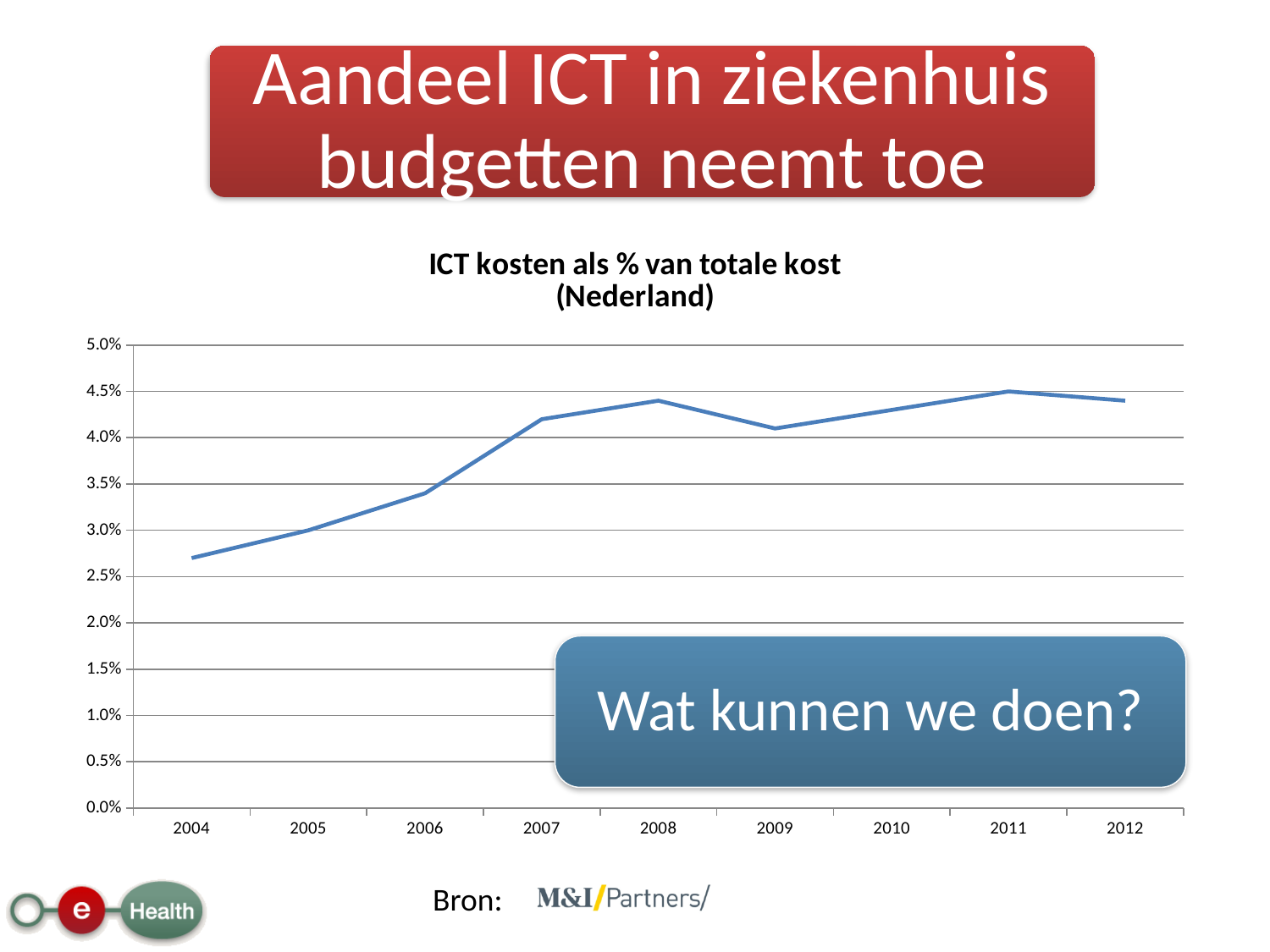
Which year has the lowest ICT cost share in the chart? 2004 Which year has a higher value, 2009 or 2011? 2011 What is the title of the chart? ICT kosten als % van totale kost (Nederland) Is the value for 2004 greater or less than 3.0%? less Is the value for 2009 greater or less than 4.5%? less Which year has a higher value, 2004 or 2008? 2008 Does the ICT cost share generally rise or fall from 2004 to 2012? rise How many years are plotted on the x axis of the chart? 9 Is the value for 2006 greater or less than 3.0%? greater What kind of chart is shown on the slide? line chart Which year has the highest ICT cost share in the chart? 2011